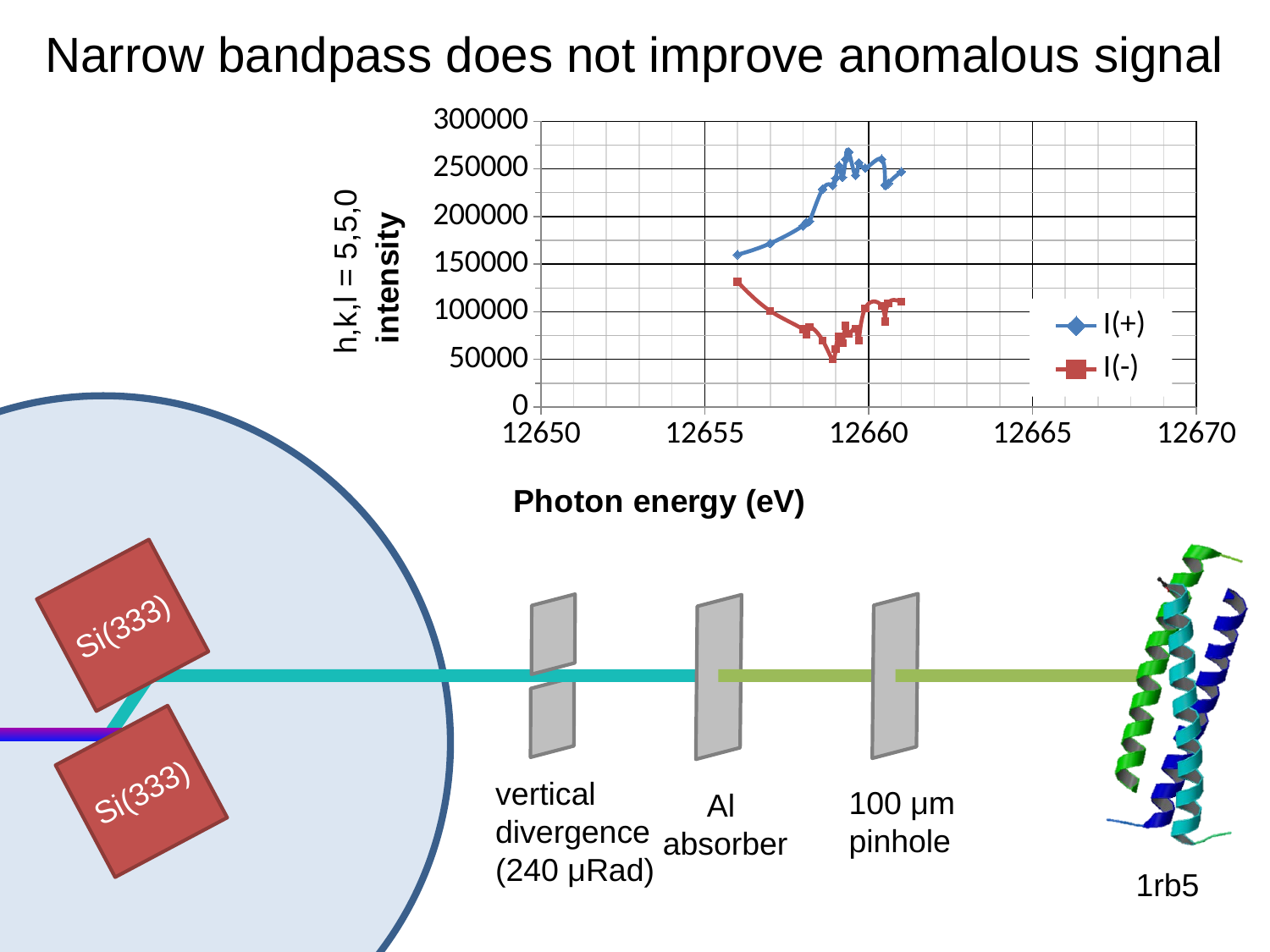
What are the two series named in the chart's legend? I(+) and I(-) What is the label of the chart's x axis? Photon energy (eV) What kind of chart is shown on the slide? line chart Does the I(-) series rise or fall as photon energy increases from 12656 eV to 12659 eV? fall Is the I(-) value at 12658 eV greater or less than 100000? less How many series does the chart's legend list? 2 Does the I(+) series rise or fall as photon energy increases from 12656 eV to 12659 eV? rise At 12656 eV, which series has the larger intensity, I(+) or I(-)? I(+) Is the I(+) value at 12659 eV greater or less than 200000? greater Is the I(-) value at 12656 eV greater or less than 150000? less